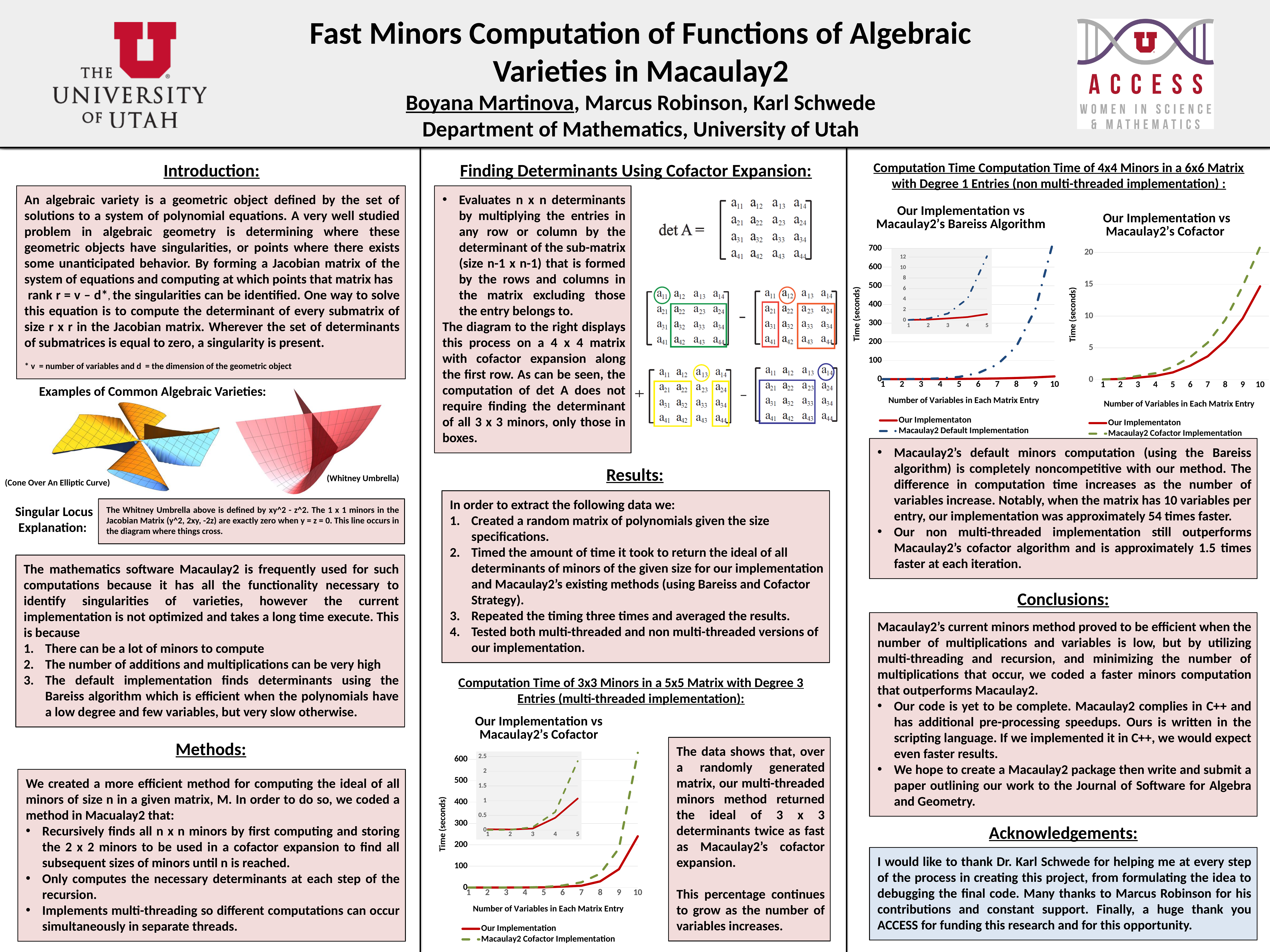
In the 'Our Implementation vs Macaulay2's Bareiss Algorithm' chart, is the Macaulay2 Default Implementation value at 10 variables greater or less than 600? greater In the 'Our Implementation vs Macaulay2's Cofactor' chart under the 3x3 Minors in a 5x5 Matrix heading, is the Our Implementation value at 10 variables greater or less than 300? less In the 'Our Implementation vs Macaulay2's Cofactor' chart under the 4x4 Minors in a 6x6 Matrix heading, is the Macaulay2 Cofactor Implementation value at 10 variables greater or less than 15? greater How many series does the legend list for the 'Our Implementation vs Macaulay2's Bareiss Algorithm' chart? 2 In the 'Our Implementation vs Macaulay2's Bareiss Algorithm' chart, do the Macaulay2 Default Implementation values rise or fall as the number of variables increases? Rise What kind of chart is 'Our Implementation vs Macaulay2's Bareiss Algorithm'? Line chart What is the y-axis label of the 'Our Implementation vs Macaulay2's Cofactor' chart under the 3x3 Minors in a 5x5 Matrix heading? Time (seconds) In the 'Our Implementation vs Macaulay2's Cofactor' chart under the 4x4 Minors in a 6x6 Matrix heading, which series is higher at 10 variables? Macaulay2 Cofactor Implementation In the 'Our Implementation vs Macaulay2's Bareiss Algorithm' chart, how many values of 'Number of Variables in Each Matrix Entry' are shown on the x axis? 10 In the 'Our Implementation vs Macaulay2's Bareiss Algorithm' chart, which series is higher at 10 variables? Macaulay2 Default Implementation